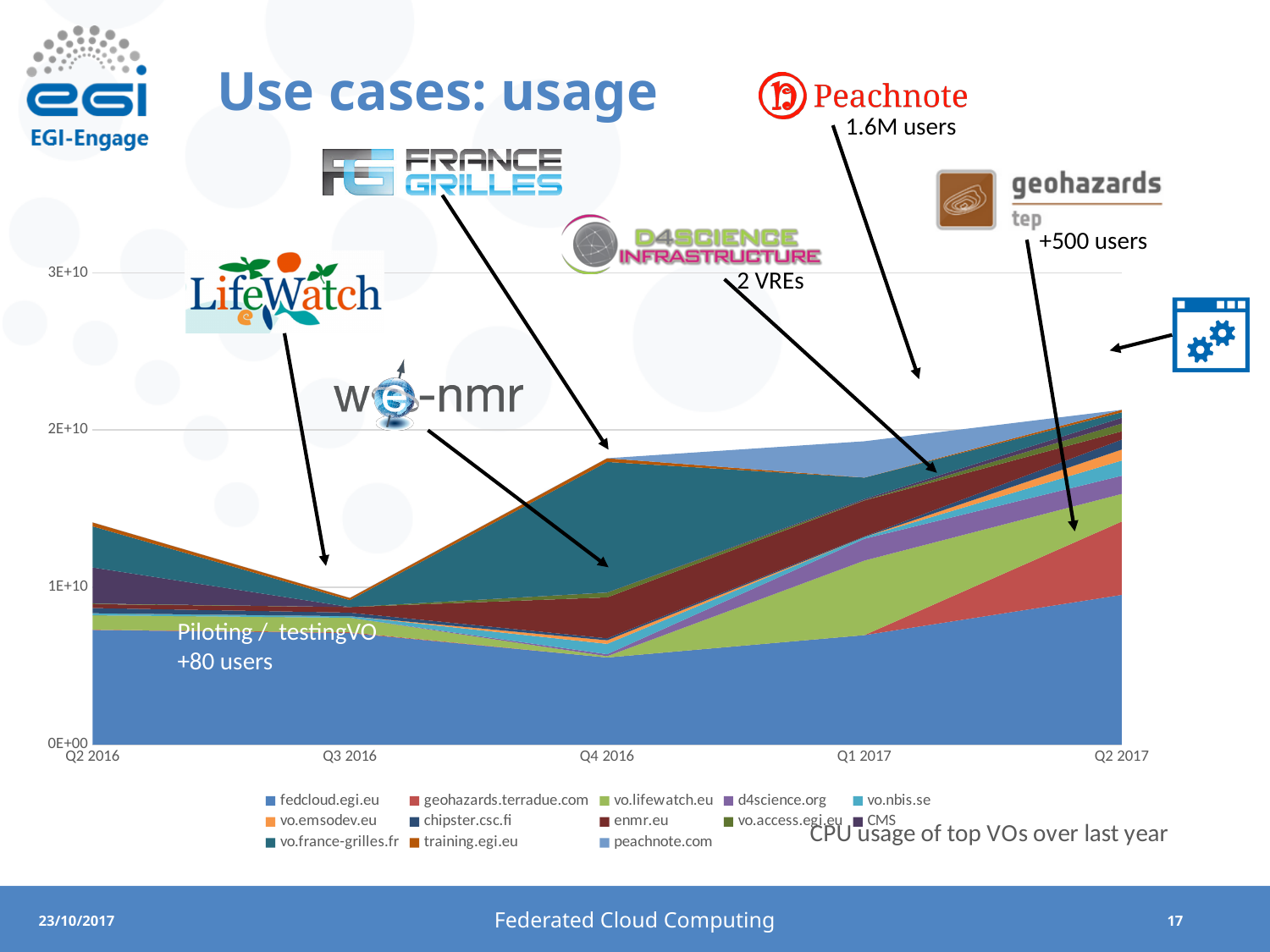
Which quarter has the highest total CPU usage in the chart? Q2 2017 Does the total CPU usage rise or fall from Q3 2016 to Q2 2017? Rise Which series is plotted at the bottom of the stacked area chart? fedcloud.egi.eu Is the total CPU usage for Q4 2016 greater or less than 2E+10? less Is the total CPU usage for Q1 2017 greater or less than 2E+10? less How many series does the chart legend list? 13 What is the title of the chart? CPU usage of top VOs over last year How many quarters are shown along the x axis of the chart? 5 Which series is larger at Q2 2017, fedcloud.egi.eu or vo.lifewatch.eu? fedcloud.egi.eu What kind of chart is shown on the slide? Stacked area chart Is the total CPU usage for Q2 2016 greater or less than 1E+10? greater Which quarter has the lowest total CPU usage in the chart? Q3 2016